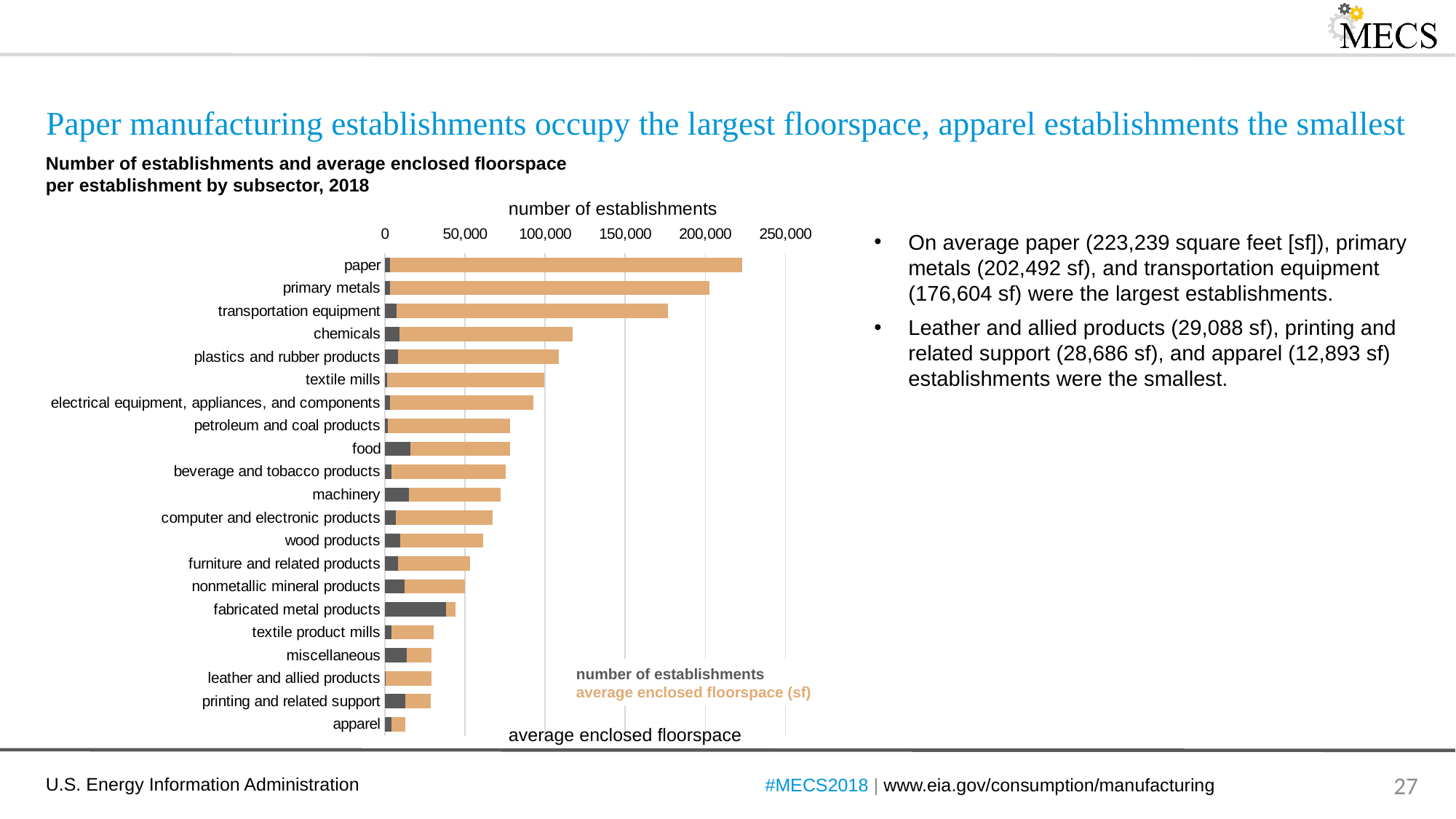
Is the number of establishments for fabricated metal products greater or less than 50,000? less Which subsector has the largest number of establishments? fabricated metal products Which subsector has the largest average enclosed floorspace? paper How many subsectors are plotted in the chart? 21 How many series does the chart's legend list? 2 What is the average enclosed floorspace for transportation equipment establishments? 176,604 sf What type of chart is shown on the slide? bar chart What is the difference in average enclosed floorspace between paper and primary metals establishments? 20,747 sf What is the average enclosed floorspace for paper establishments? 223,239 sf Which subsector has the larger average enclosed floorspace, transportation equipment or chemicals? transportation equipment Is the average enclosed floorspace for chemicals greater or less than 100,000? greater Which subsector has the smallest average enclosed floorspace? apparel